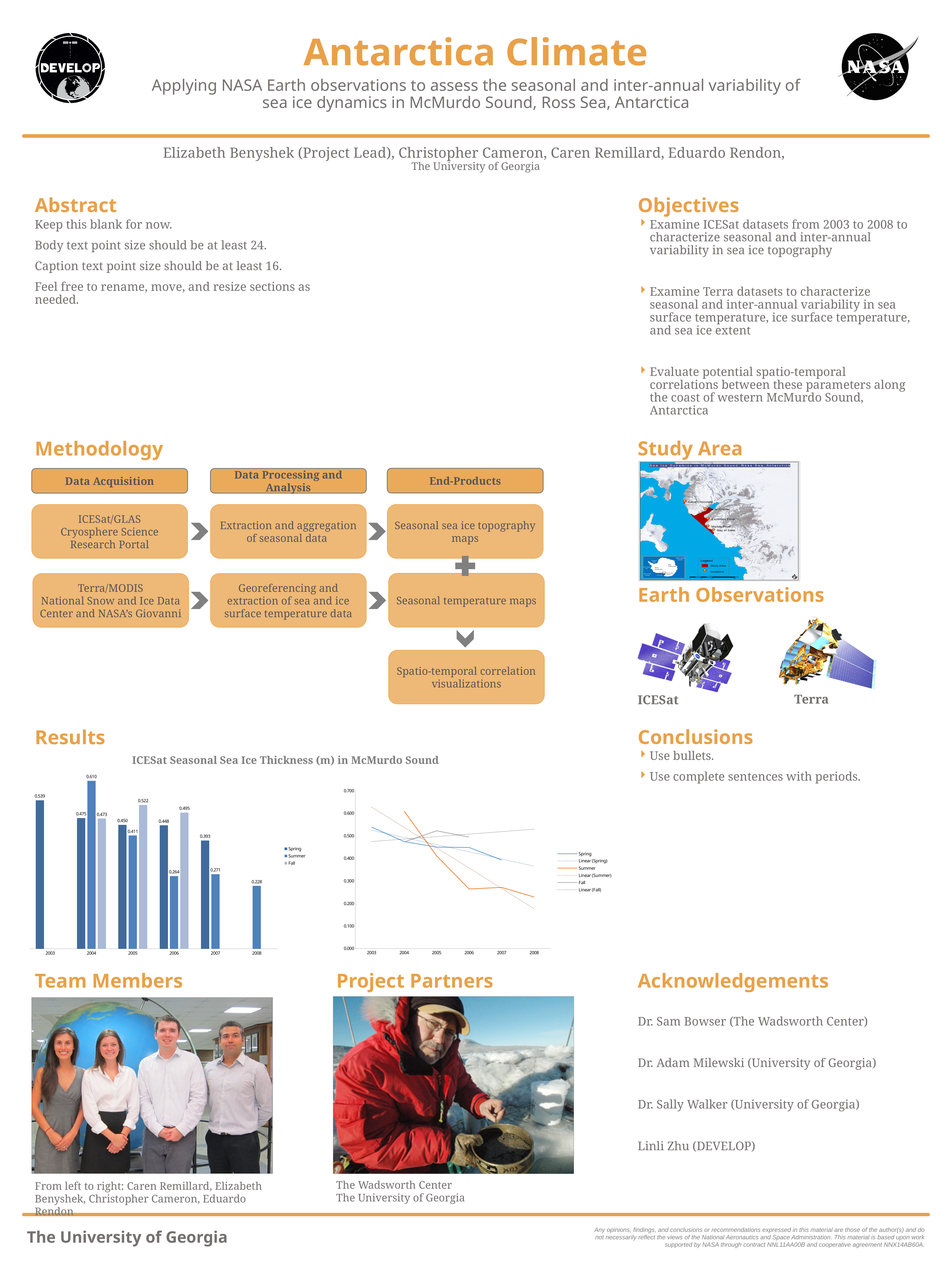
In the bar chart titled 'ICESat Seasonal Sea Ice Thickness (m) in McMurdo Sound', what is the Summer value for 2004? 0.610 In the line chart on the right of the Results section, does the Summer line rise or fall from 2004 to 2008? Fall In the bar chart titled 'ICESat Seasonal Sea Ice Thickness (m) in McMurdo Sound', how many years are shown on the x axis? 6 In the bar chart titled 'ICESat Seasonal Sea Ice Thickness (m) in McMurdo Sound', which year and season has the highest bar? Summer 2004 In the bar chart titled 'ICESat Seasonal Sea Ice Thickness (m) in McMurdo Sound', what is the difference between the Fall and Summer values for 2005? 0.111 In the line chart on the right of the Results section, how many entries does the legend list? 6 In the bar chart titled 'ICESat Seasonal Sea Ice Thickness (m) in McMurdo Sound', what is the Spring value for 2003? 0.539 What kind of chart is the left chart in the Results section? Bar chart In the bar chart titled 'ICESat Seasonal Sea Ice Thickness (m) in McMurdo Sound', what is the Fall value for 2006? 0.495 In the bar chart titled 'ICESat Seasonal Sea Ice Thickness (m) in McMurdo Sound', how many series does the legend list? 3 In the bar chart titled 'ICESat Seasonal Sea Ice Thickness (m) in McMurdo Sound', what is the lowest value shown? 0.228 In the bar chart titled 'ICESat Seasonal Sea Ice Thickness (m) in McMurdo Sound', which is larger for 2006, the Spring value or the Summer value? Spring